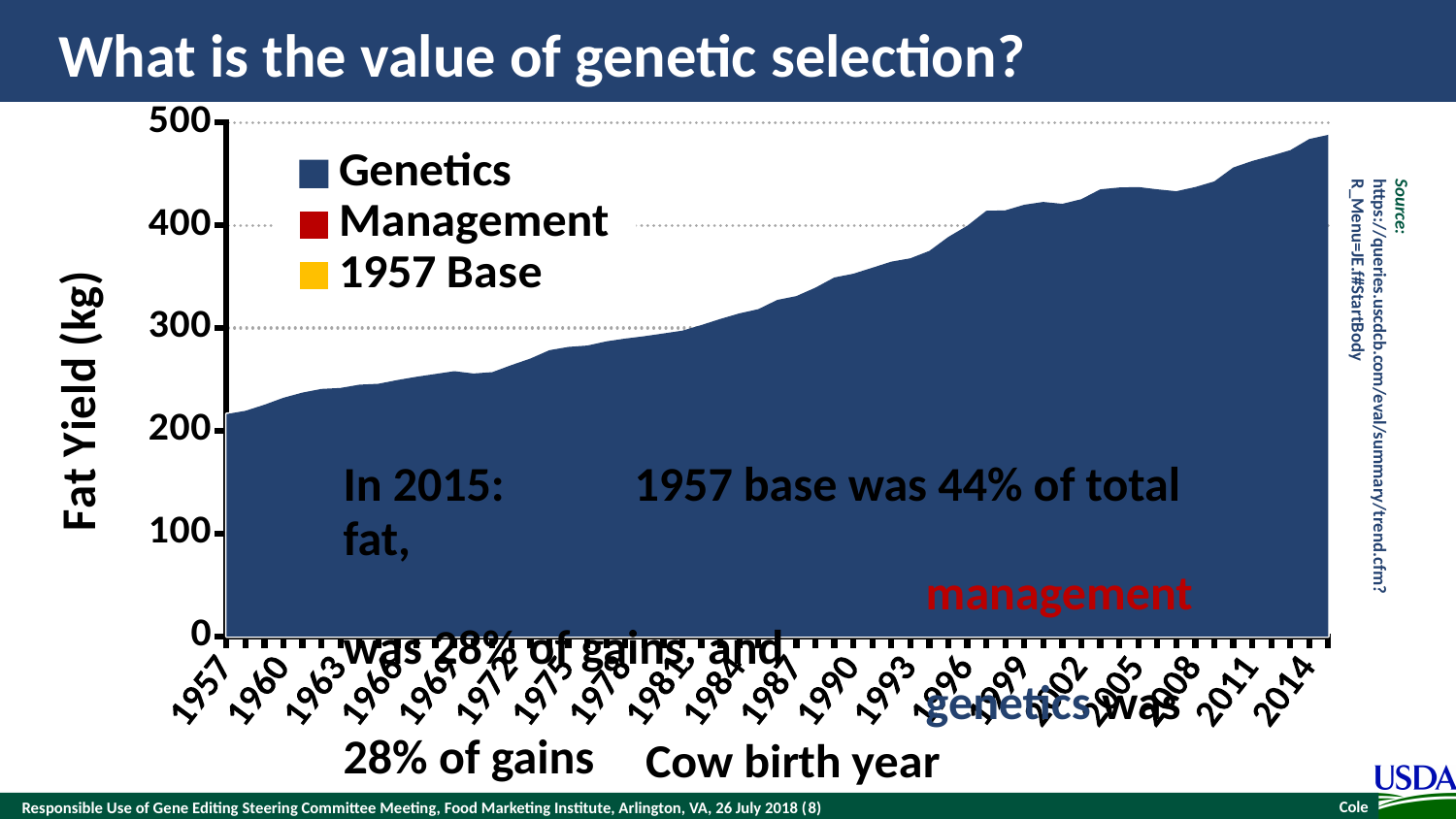
Is the plotted fat yield for 2014 greater or less than 400? greater How many series does the chart legend list? 3 Is the plotted fat yield for 1975 greater or less than 300? less How many year labels are shown on the x axis? 20 What kind of chart is shown on the slide? area chart Do the plotted values rise or fall as cow birth year increases from 1957 to 2014? rise Which has the larger plotted fat yield, cow birth year 1987 or 1963? 1987 Is the plotted fat yield for 1957 greater or less than 200? greater What is the title of the y axis? Fat Yield (kg) Which cow birth year has the lowest plotted fat yield? 1957 Which series is shown in dark blue in the legend? Genetics